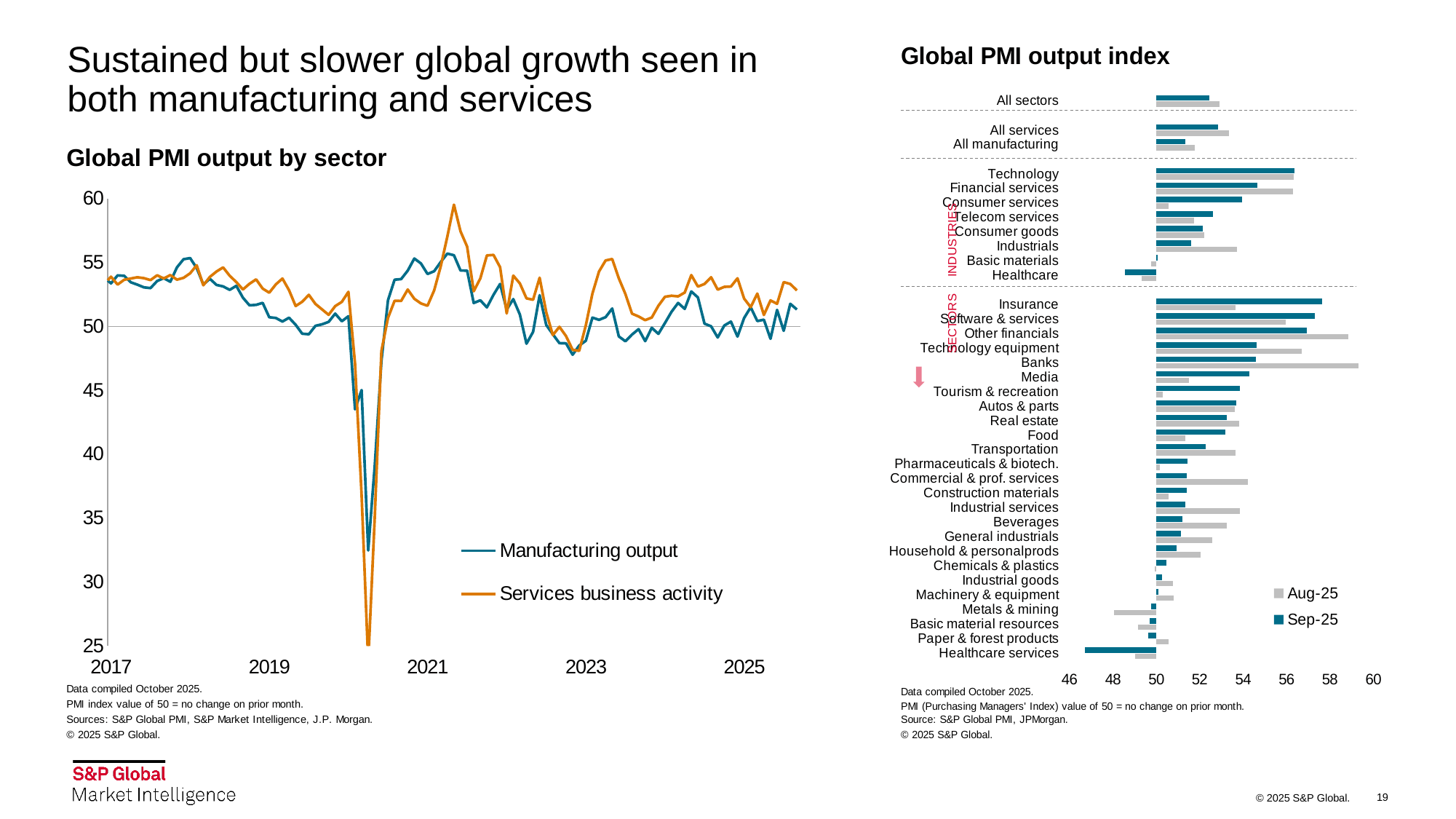
How many series does the legend of the 'Global PMI output by sector' chart list? 2 In the 'Global PMI output index' chart, which category has the highest Aug-25 value? Banks In the 'Global PMI output by sector' chart, which series fell to the lower value in 2020, Manufacturing output or Services business activity? Services business activity How many categories are listed in the INDUSTRIES group of the 'Global PMI output index' chart? 8 In the 'Global PMI output by sector' chart, is the lowest value of Services business activity greater or less than 30? less What kind of chart is the 'Global PMI output index' chart on the right? bar chart How many series does the legend of the 'Global PMI output index' chart list? 2 In the 'Global PMI output index' chart, which has the larger Sep-25 value, Insurance or Banks? Insurance In the 'Global PMI output index' chart, is the Sep-25 value for Technology greater or less than 56? greater What kind of chart is the 'Global PMI output by sector' chart on the left? line chart In the 'Global PMI output index' chart, which category has the lowest Sep-25 value? Healthcare services In the 'Global PMI output index' chart, is the Sep-25 value for Healthcare services greater or less than 48? less